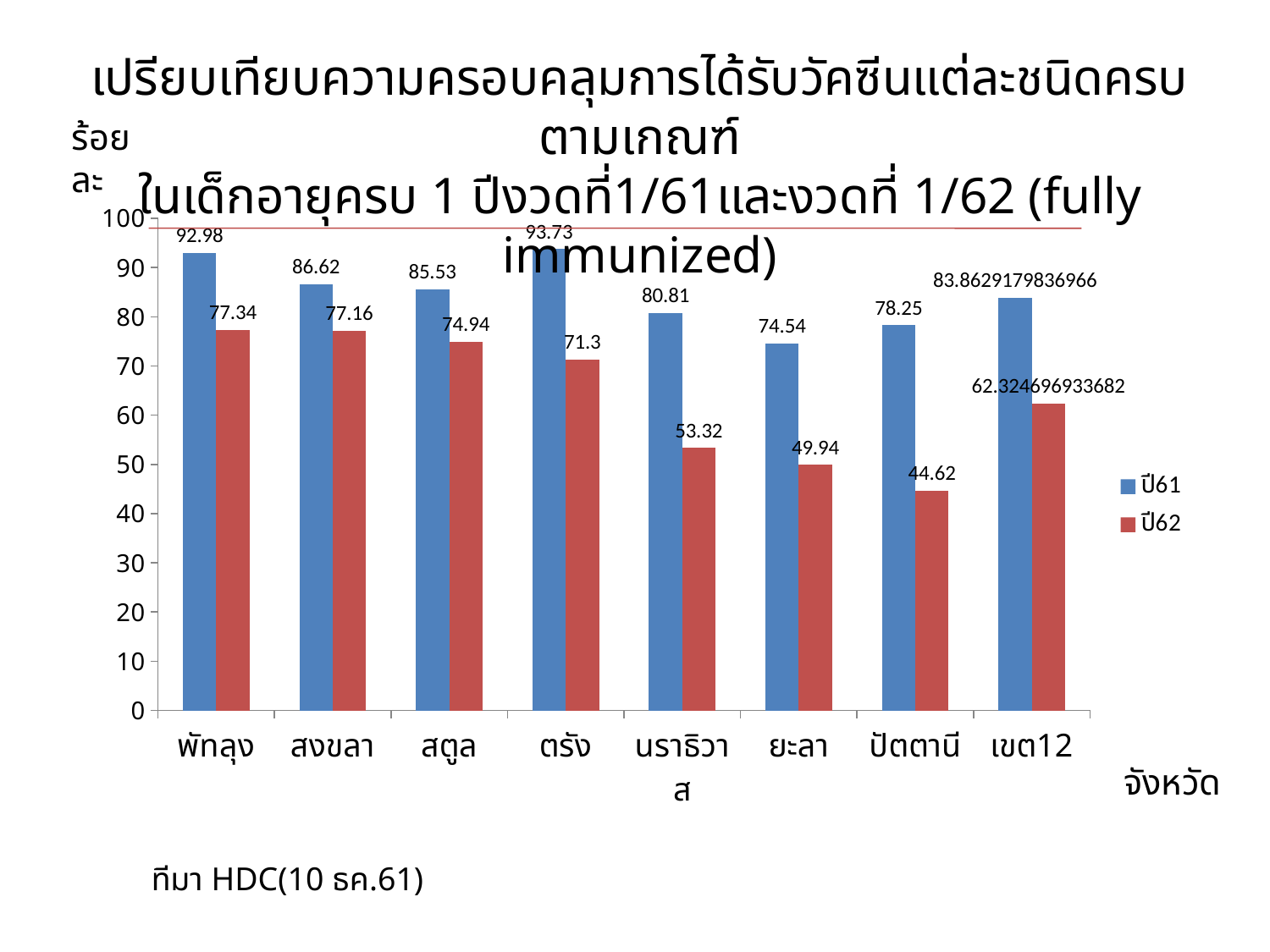
What is the ปี62 value for ปัตตานี? 44.62 What kind of chart is shown on the slide? bar chart How many series does the legend list? 2 Is the ปี62 value for เขต12 greater or less than 70? less Which category has the lowest ปี62 value? ปัตตานี What is the difference between the ปี61 and ปี62 values for ยะลา? 24.6 What is the ปี61 value for ตรัง? 93.73 Which colour represents the ปี62 series? red Which is larger: the ปี62 value for พัทลุง or the ปี62 value for สงขลา? พัทลุง What is the ปี62 value for นราธิวาส? 53.32 How many categories are shown on the x axis? 8 Which province has the highest ปี61 value? ตรัง